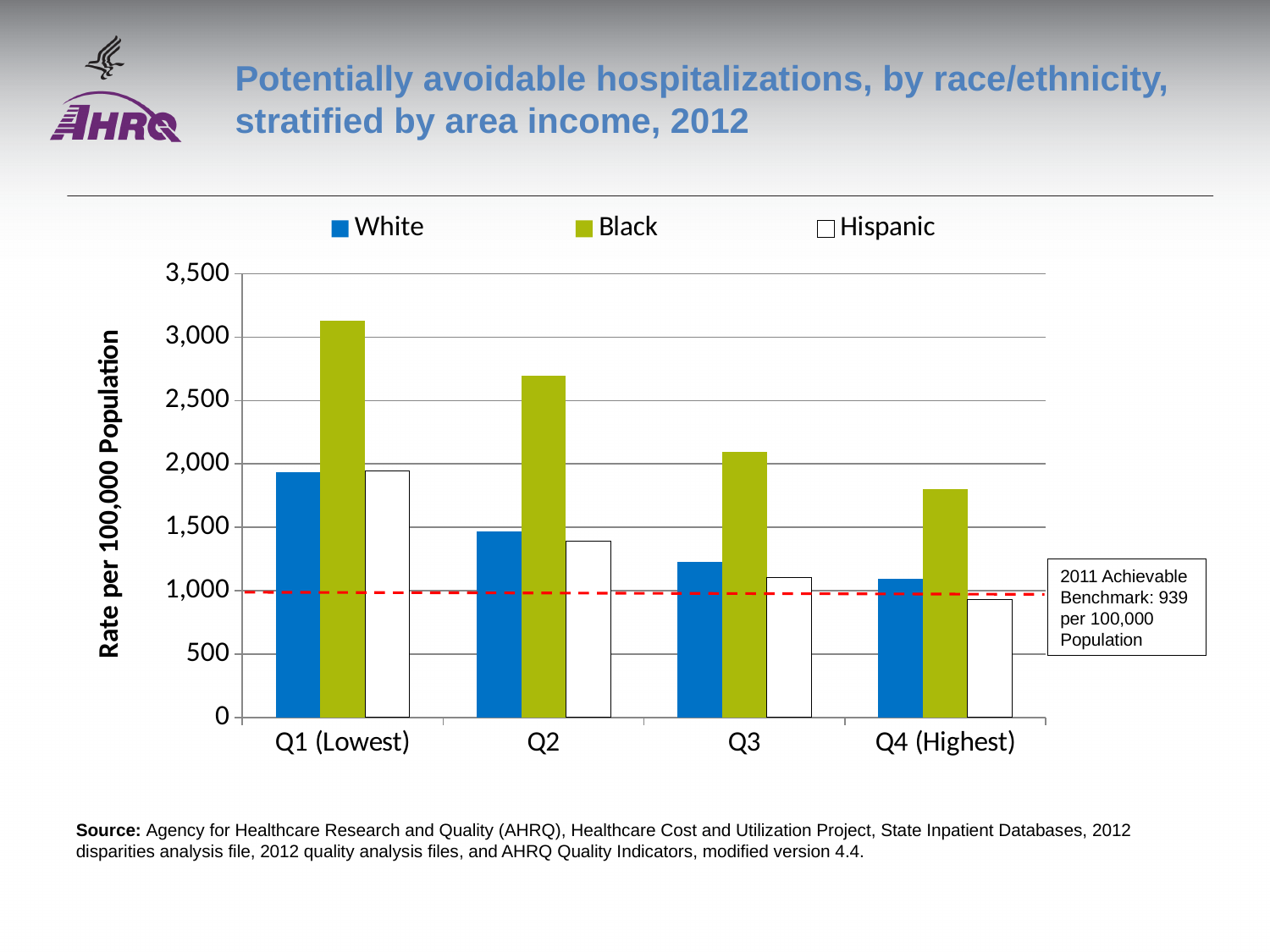
How many income quartile categories are shown on the x axis? 4 How many series does the legend list? 3 Which income quartile has the highest rate for Black? Q1 (Lowest) Do the rates for Black rise or fall from Q1 (Lowest) to Q4 (Highest)? fall Is the value for White in Q3 greater or less than 1,000? greater Which income quartile has the lowest rate for Black? Q4 (Highest) Is the value for Black in Q1 (Lowest) greater or less than 3,000? greater Is the value for Black in Q2 greater or less than 2,500? greater What is the 2011 achievable benchmark shown on the chart? 939 per 100,000 Population What kind of chart is shown on the slide? Bar chart In Q2, which is larger, the rate for White or the rate for Black? Black